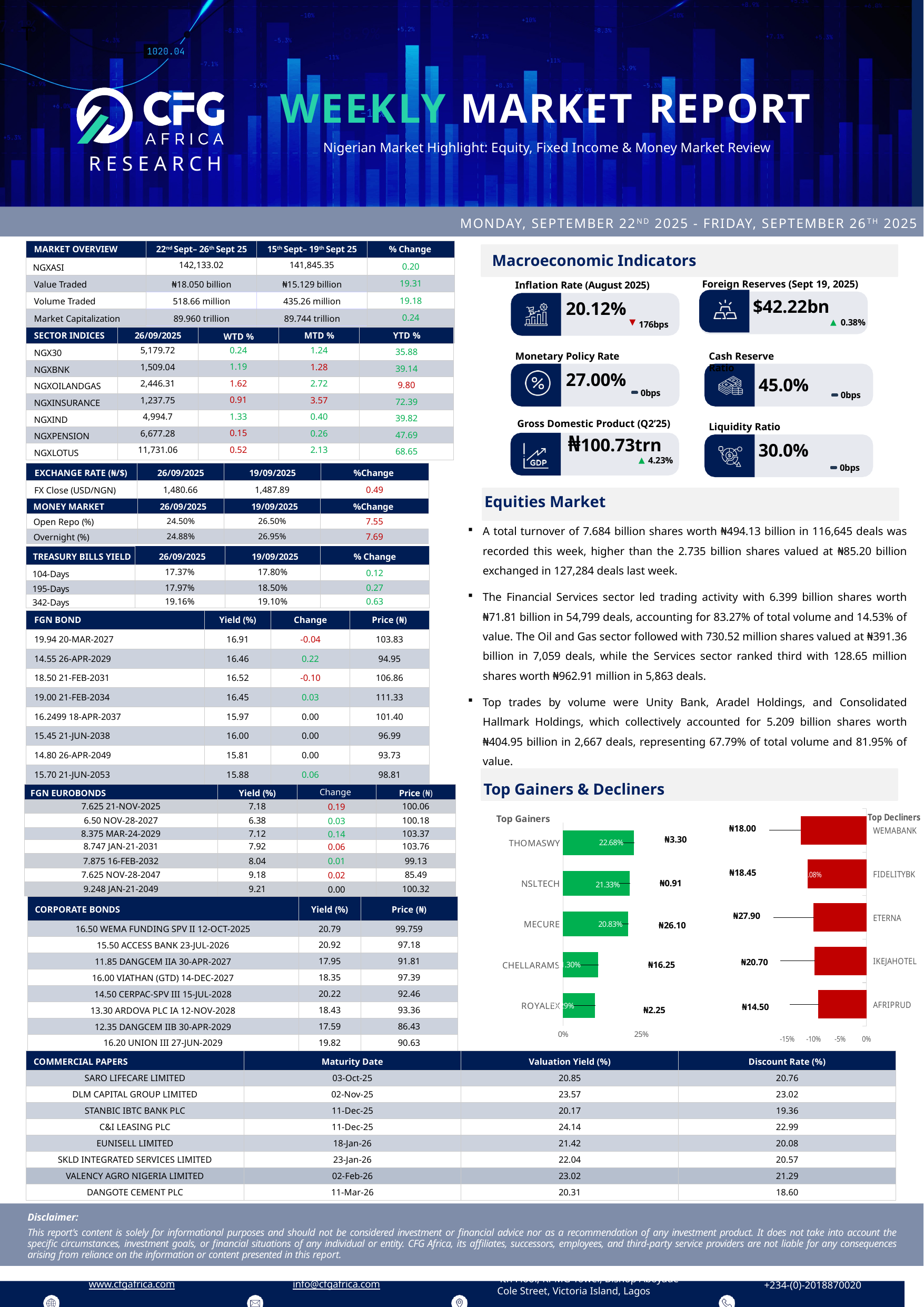
On the Top Gainers chart, which stock has the highest percentage gain? THOMASWY What kind of chart is used for the Top Decliners? Bar chart On the Top Gainers chart, what is the percentage gain shown for THOMASWY? 22.68% On the Top Gainers chart, which has the larger percentage gain, THOMASWY or MECURE? THOMASWY On the Top Gainers chart, what price is shown next to MECURE? ₦26.10 On the Top Decliners chart, what price is shown next to ETERNA? ₦27.90 On the Top Gainers chart, what is the percentage gain shown for MECURE? 20.83% How many stocks are shown on the Top Gainers chart? 5 How many stocks are shown on the Top Decliners chart? 5 On the Top Gainers chart, what is the percentage gain shown for NSLTECH? 21.33% On the Top Gainers chart, what is the difference in percentage gain between THOMASWY and NSLTECH? 1.35 percentage points On the Top Gainers chart, is the value for CHELLARAMS greater or less than 25%? less